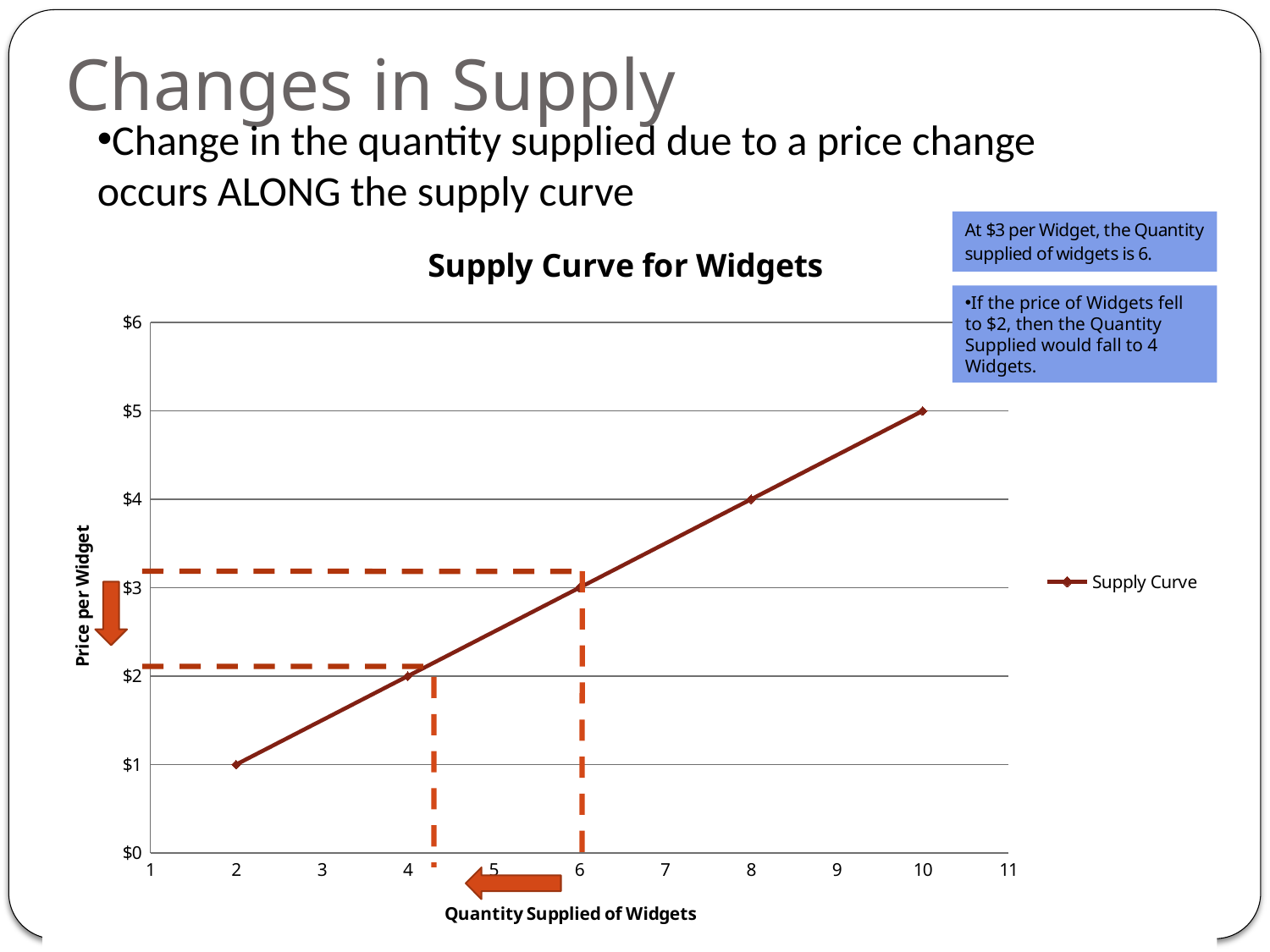
What is the price per widget when the quantity supplied is 6? $3 What is the name of the series shown in the legend? Supply Curve What kind of chart is shown on the slide? line chart How many series does the chart legend list? 1 What is the title of the chart? Supply Curve for Widgets How many data points are plotted on the supply curve? 5 What is the price per widget when the quantity supplied is 4? $2 Does the price per widget rise or fall as the quantity supplied increases along the x axis? rise What is the difference in price per widget between a quantity supplied of 6 and a quantity supplied of 4? $1 What is the price per widget when the quantity supplied is 10? $5 What is the highest price per widget plotted on the supply curve? $5 What is the quantity supplied of widgets when the price is $4? 8